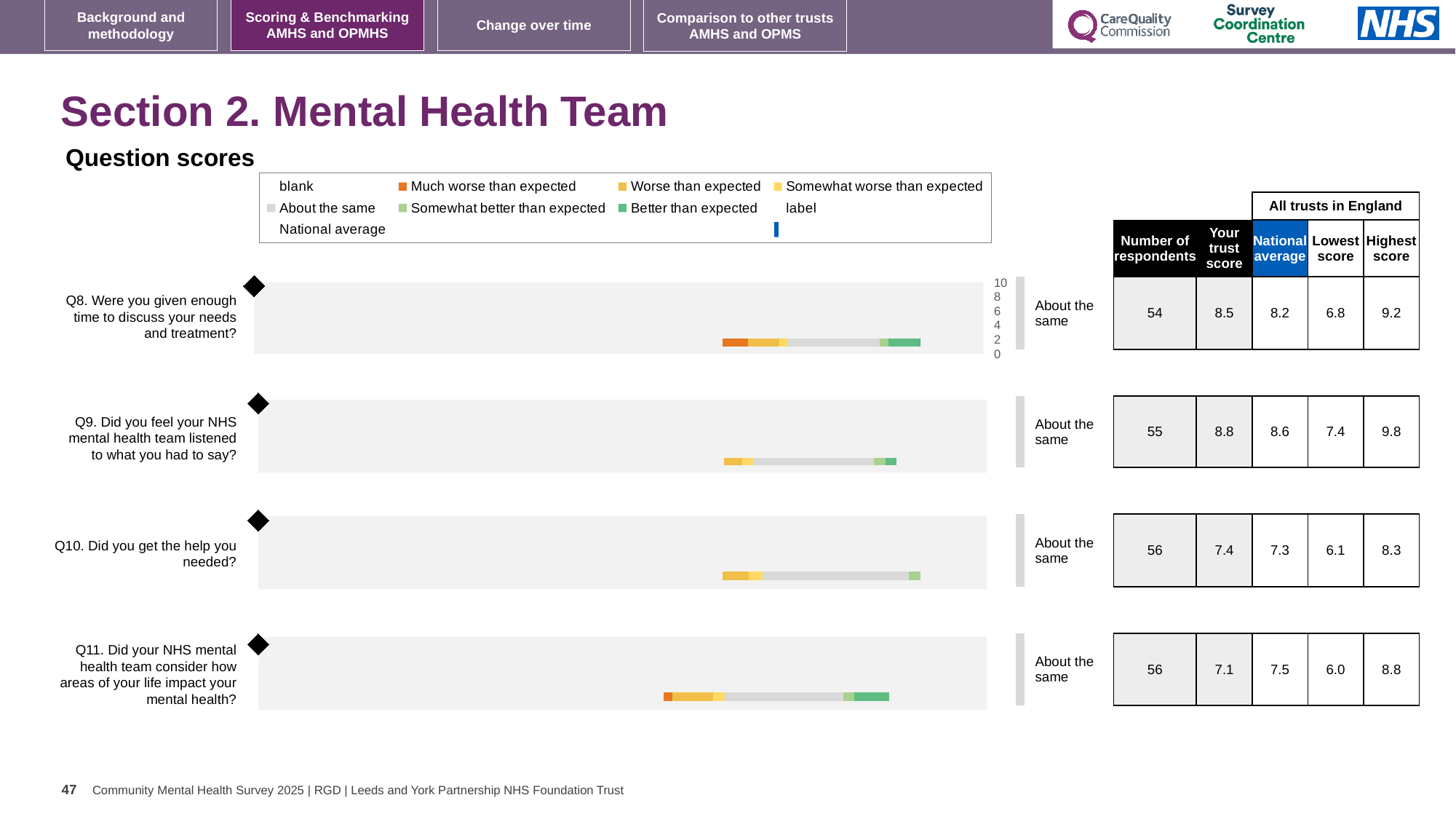
What is the difference between the trust score and the national average for Q8? 0.3 How many questions (Q8 to Q11) have a chart on the slide? 4 For Q11, which is larger: the trust score or the national average? National average How many respondents answered Q10 (Did you get the help you needed)? 56 What is the national average for Q9 (Did you feel your NHS mental health team listened to what you had to say)? 8.6 What is the highest score among all trusts in England for Q9? 9.8 Which question has the highest trust score? Q9 What kind of chart is used to show the question scores for Q8 to Q11? bar chart What is the trust score for Q8 (Were you given enough time to discuss your needs and treatment)? 8.5 Which question has the lowest trust score? Q11 What is the lowest score among all trusts in England for Q11? 6.0 What benchmark category is shown next to the chart for Q10? About the same